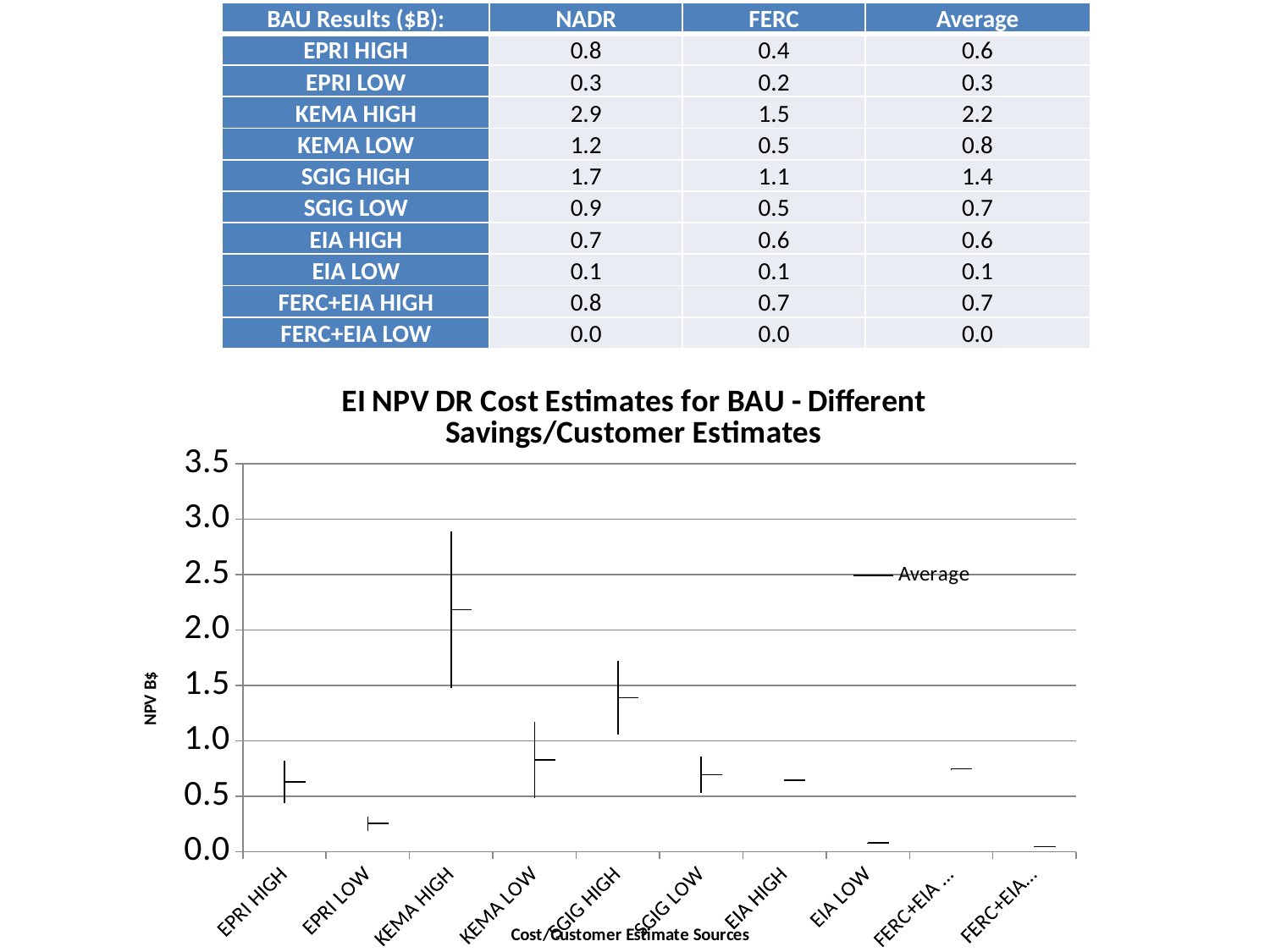
What is the difference between the Average values for KEMA HIGH and SGIG HIGH? 0.8 What is the label on the vertical axis of the chart? NPV B$ Is the Average value for EPRI LOW greater or less than 0.5? less What is the Average value for KEMA LOW? 0.8 Is the Average value for KEMA HIGH greater or less than 2.0? greater What is the title of the chart? EI NPV DR Cost Estimates for BAU - Different Savings/Customer Estimates What is the Average value for SGIG HIGH? 1.4 Which is larger, the Average value for SGIG HIGH or for KEMA LOW? SGIG HIGH How many categories are shown on the x axis of the chart? 10 Which category has the lowest Average value in the chart? FERC+EIA LOW Which category has the highest Average value in the chart? KEMA HIGH How many series does the chart legend list? 1